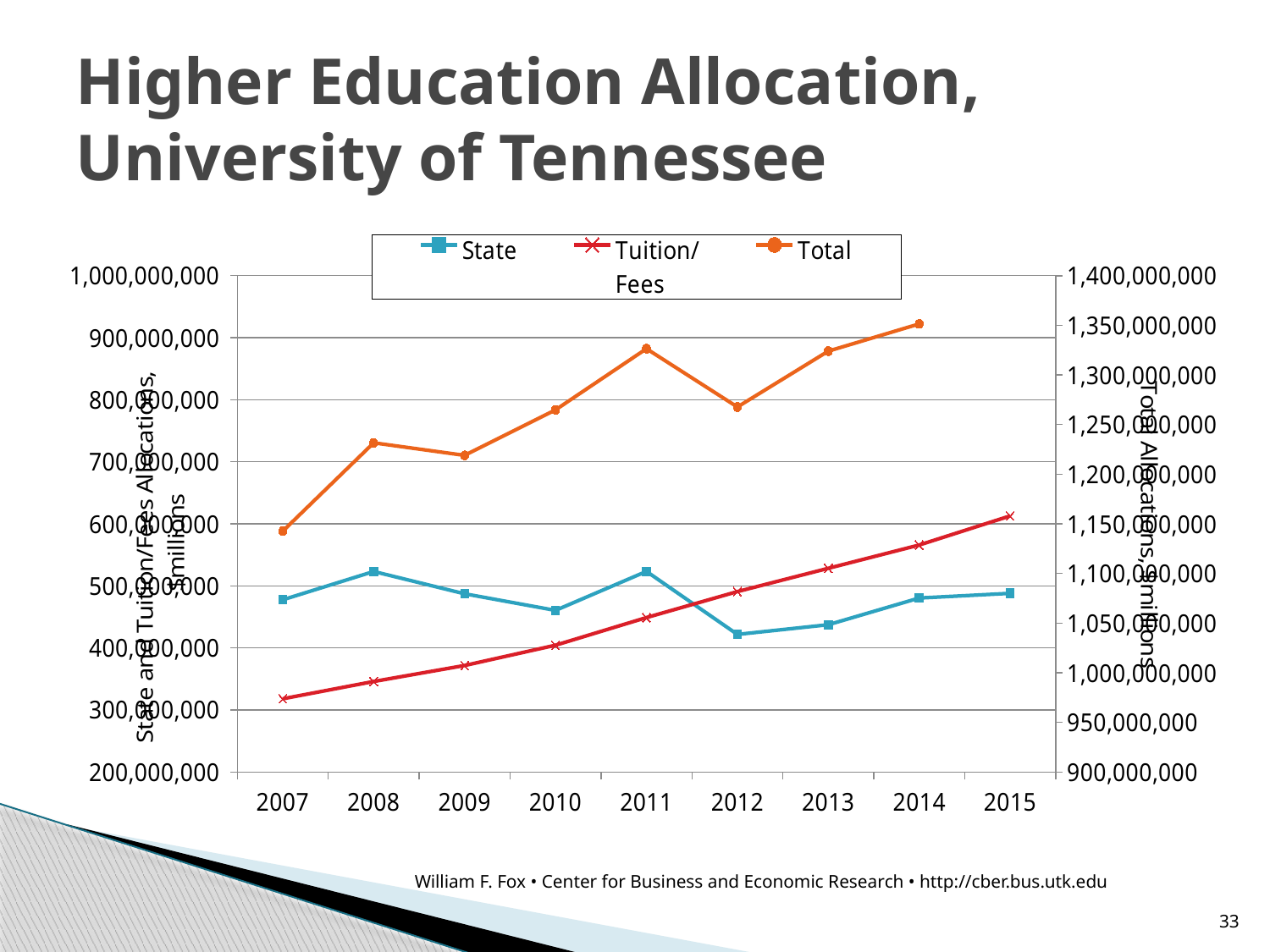
How many years are shown on the x axis? 9 Which series are listed in the legend? State, Tuition/Fees, Total In 2007, which is larger, the State value or the Tuition/Fees value? State Is the Tuition/Fees value for 2007 greater or less than 400,000,000? less Does the Tuition/Fees series rise or fall from 2007 to 2015? rise Is the Total value for 2011 (right axis) greater or less than 1,300,000,000? greater How many series does the legend list? 3 In which year is the Tuition/Fees value highest? 2015 What kind of chart is shown on the slide? line chart In which year is the State value lowest? 2012 In 2015, which is larger, the State value or the Tuition/Fees value? Tuition/Fees In which year is the Total value lowest? 2007